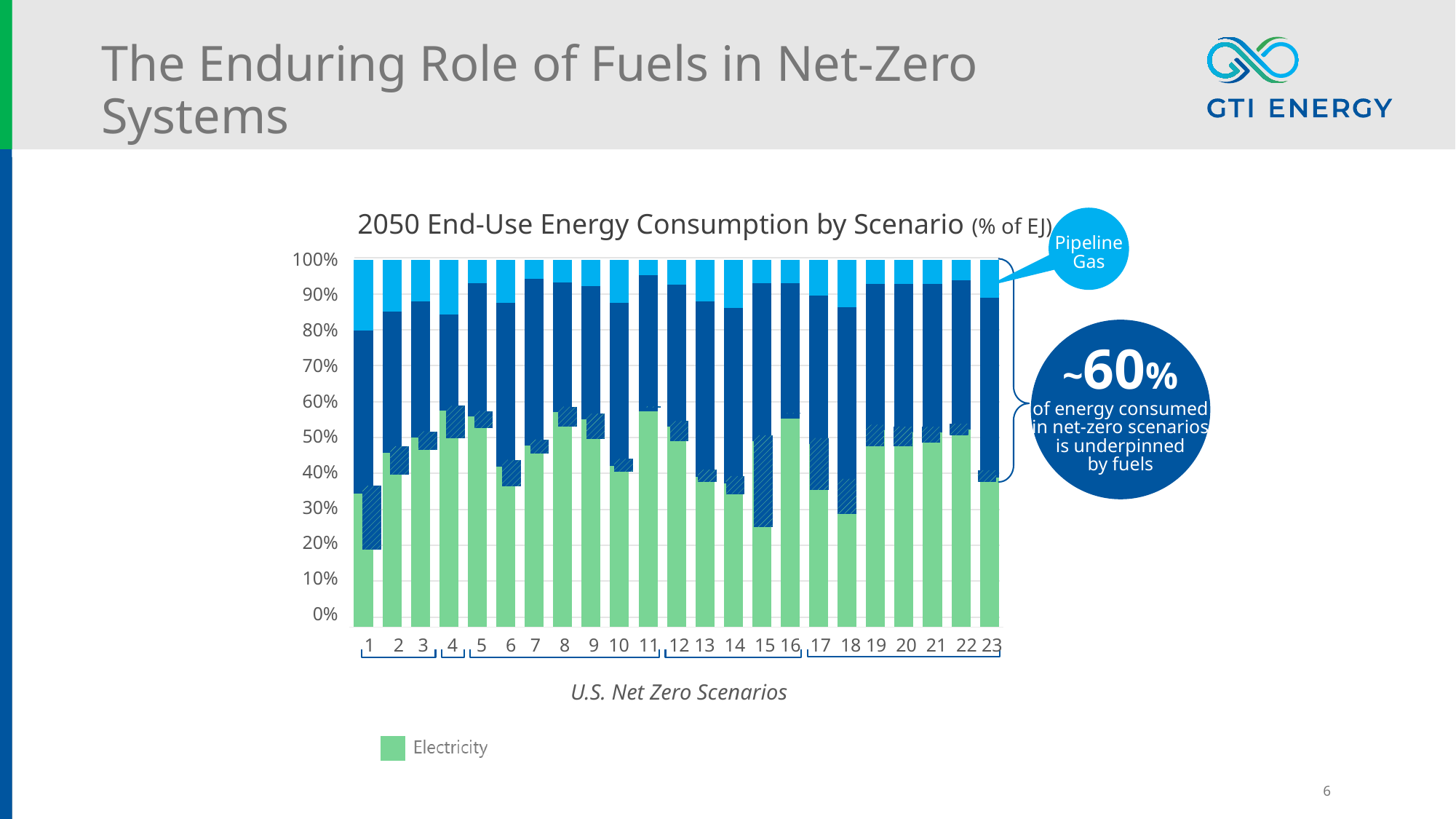
Which scenario has the lowest Electricity share? 1 Which series is named in the chart's legend? Electricity What is the title of the chart? 2050 End-Use Energy Consumption by Scenario (% of EJ) How many scenarios are plotted along the x axis of the chart? 23 What is the total height of the stacked bar for scenario 5? 100% Is the Electricity value for scenario 16 greater or less than 50%? greater Is the Electricity value for scenario 11 greater or less than 50%? greater How many series does the chart's legend list? 1 What kind of chart is shown on the slide? Stacked bar chart Is the Electricity value for scenario 15 greater or less than 30%? less Which scenario has the largest light-blue (Pipeline Gas) segment? 1